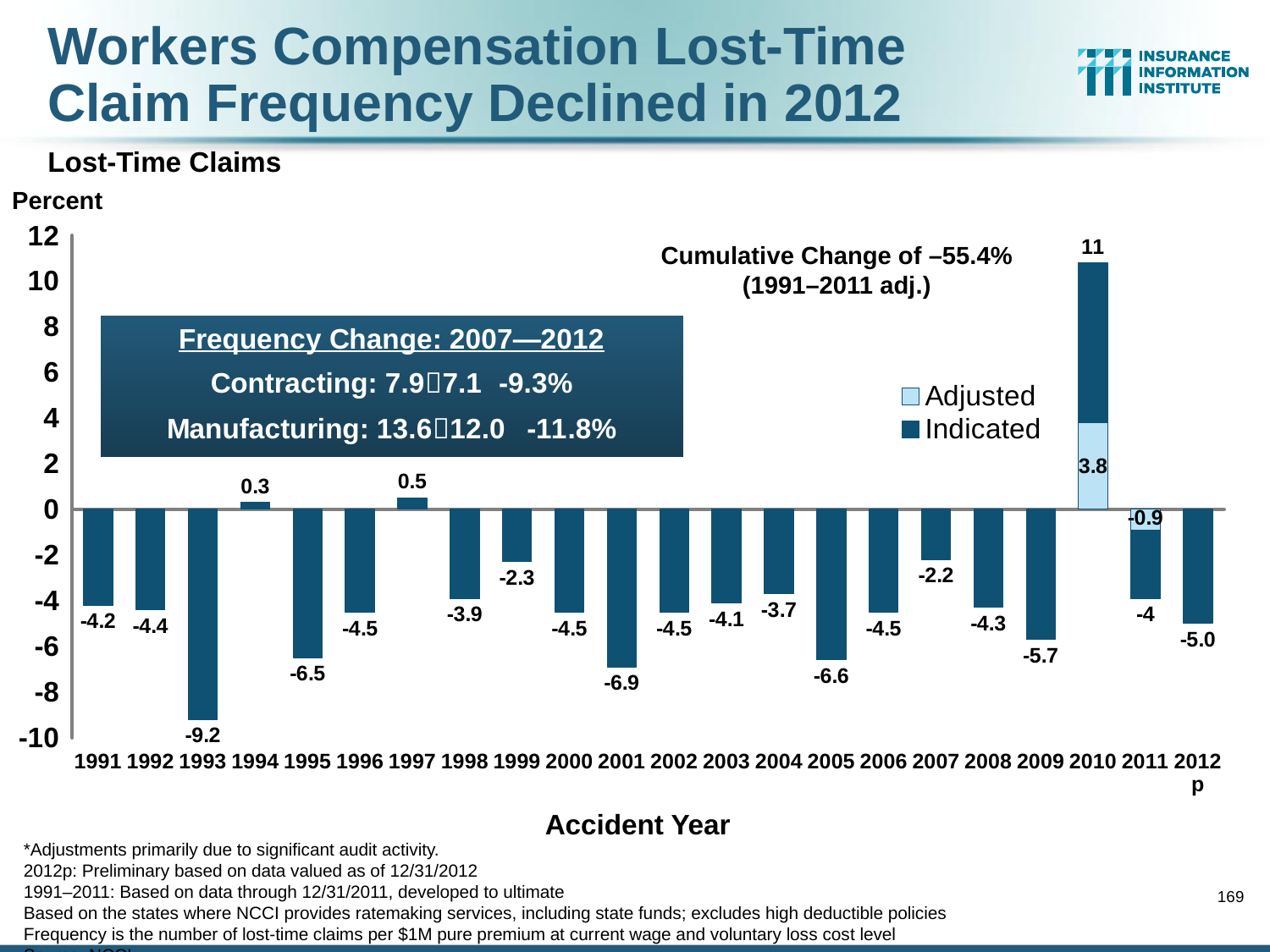
Which accident year has the lowest Indicated value? 1993 Which is larger, the value for 1994 or the value for 1997? 1997 How many series does the legend list? 2 What kind of chart is shown on the slide? Bar chart What is the Indicated value for accident year 2010? 11 What is the Adjusted value for accident year 2010? 3.8 Which accident year has the highest Indicated value? 2010 What is the Indicated value for accident year 1993? -9.2 How many accident years are shown on the x axis? 22 What is the value shown for accident year 2012p? -5.0 What cumulative change for 1991–2011 (adj.) is stated on the chart? –55.4% What is the difference between the values for 2001 and 2005? 0.3